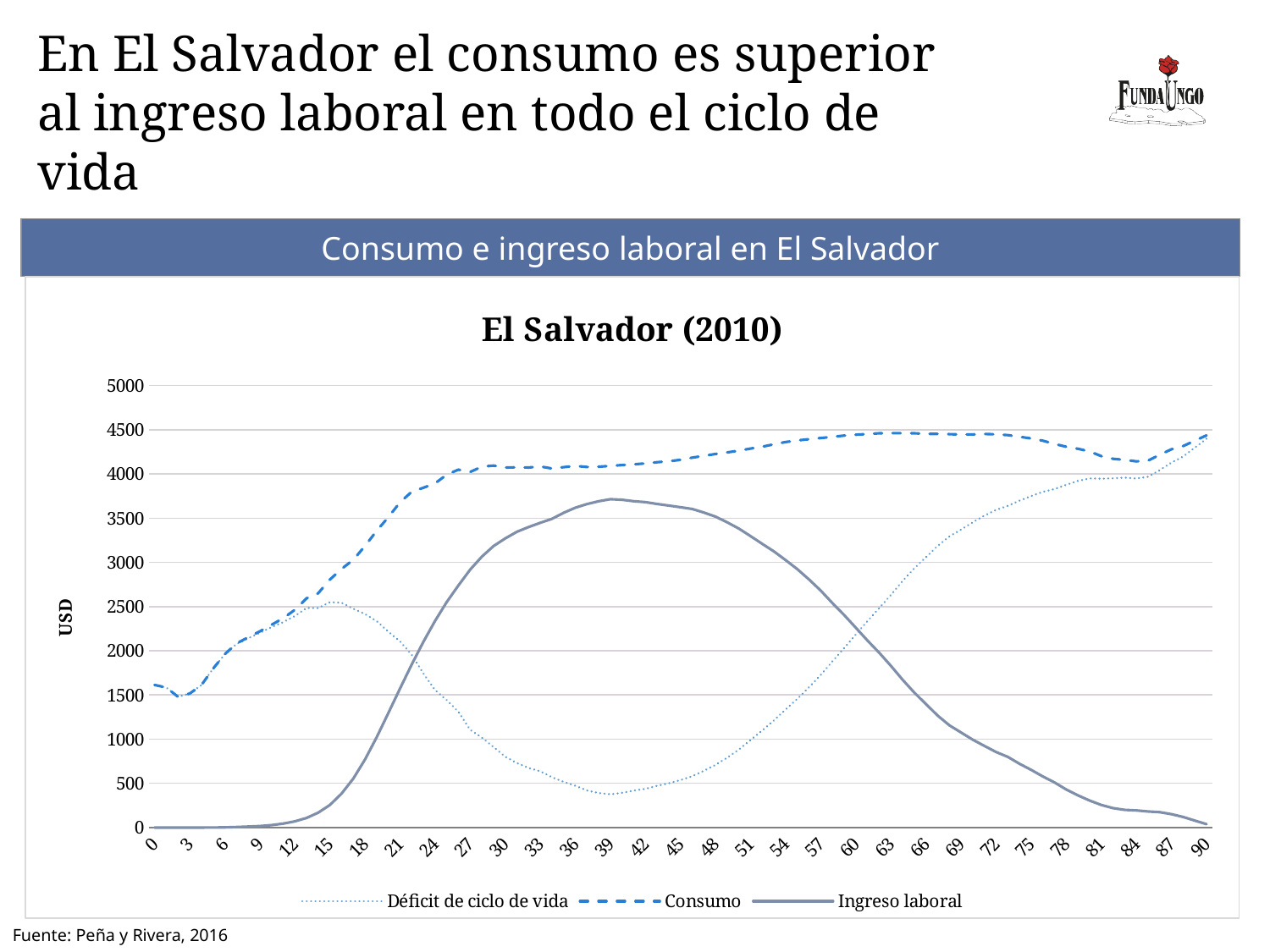
What kind of chart is shown on the slide? Line chart Is the value of Déficit de ciclo de vida at age 39 greater or less than 500? less Is the value of Ingreso laboral at age 39 greater or less than 3000? greater How many age ticks are shown on the x axis? 31 Does Ingreso laboral rise or fall between age 39 and age 90? Fall Is the value of Consumo at age 60 greater or less than 4000? greater What are the three series listed in the legend? Déficit de ciclo de vida, Consumo, Ingreso laboral At age 39, which is larger: Consumo or Ingreso laboral? Consumo How many series does the legend list? 3 At age 75, which is larger: Déficit de ciclo de vida or Ingreso laboral? Déficit de ciclo de vida What is the label on the vertical axis? USD